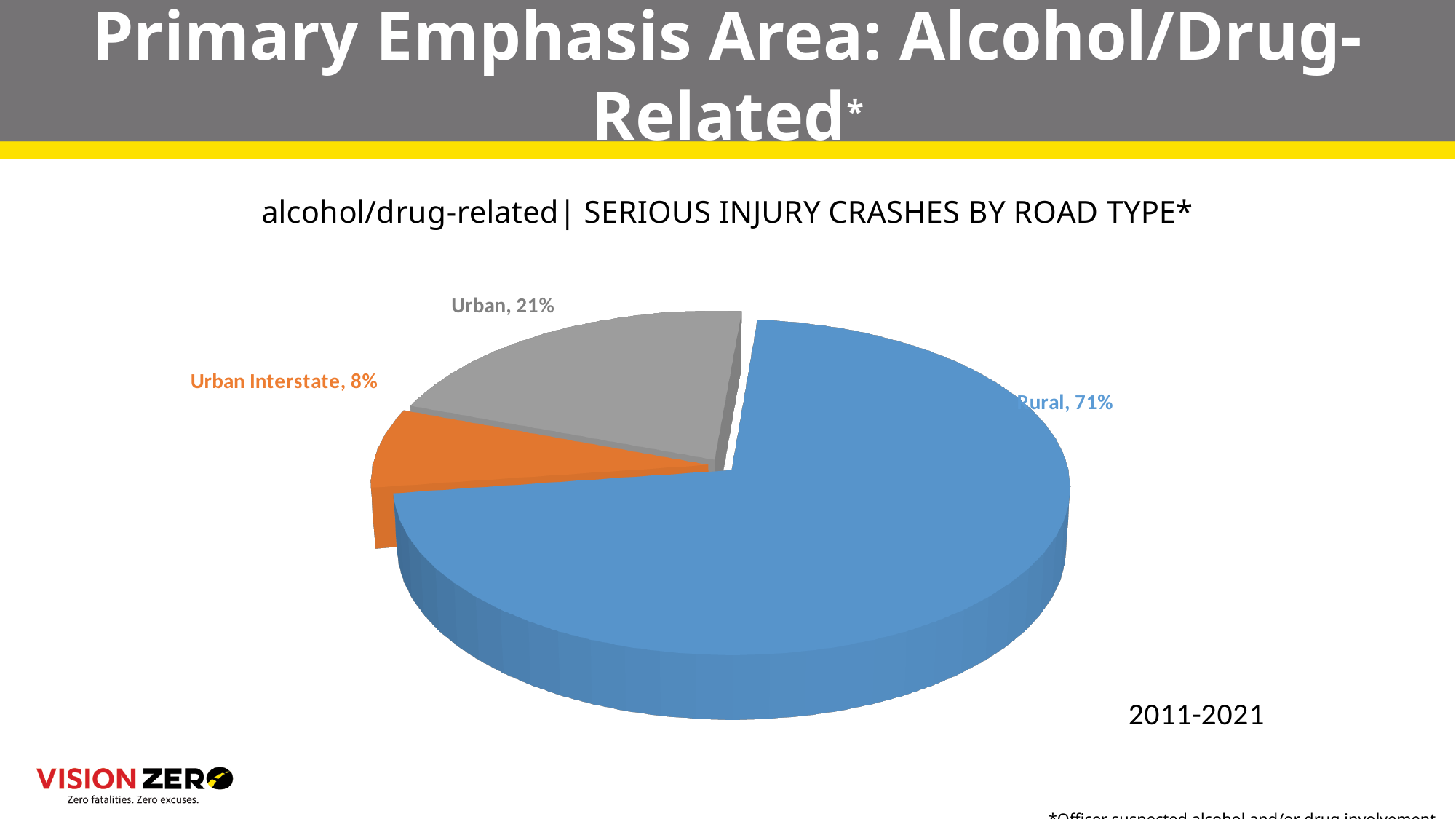
What colour is the Rural slice of the pie chart? Blue Which road type has the largest share of alcohol/drug-related serious injury crashes? Rural What share of alcohol/drug-related serious injury crashes occurred on Urban Interstate roads? 8% Which road type has the smallest share of alcohol/drug-related serious injury crashes? Urban Interstate How many road type categories are shown in the pie chart? 3 What is the difference in percentage points between the Urban and Urban Interstate shares? 13 What type of chart is shown on the slide? Pie chart What share of alcohol/drug-related serious injury crashes occurred on Urban roads? 21% What is the difference in percentage points between the Rural and Urban shares? 50 What share of alcohol/drug-related serious injury crashes occurred on Rural roads? 71% What time period does the chart cover? 2011-2021 Which is larger, the Urban share or the Urban Interstate share? Urban